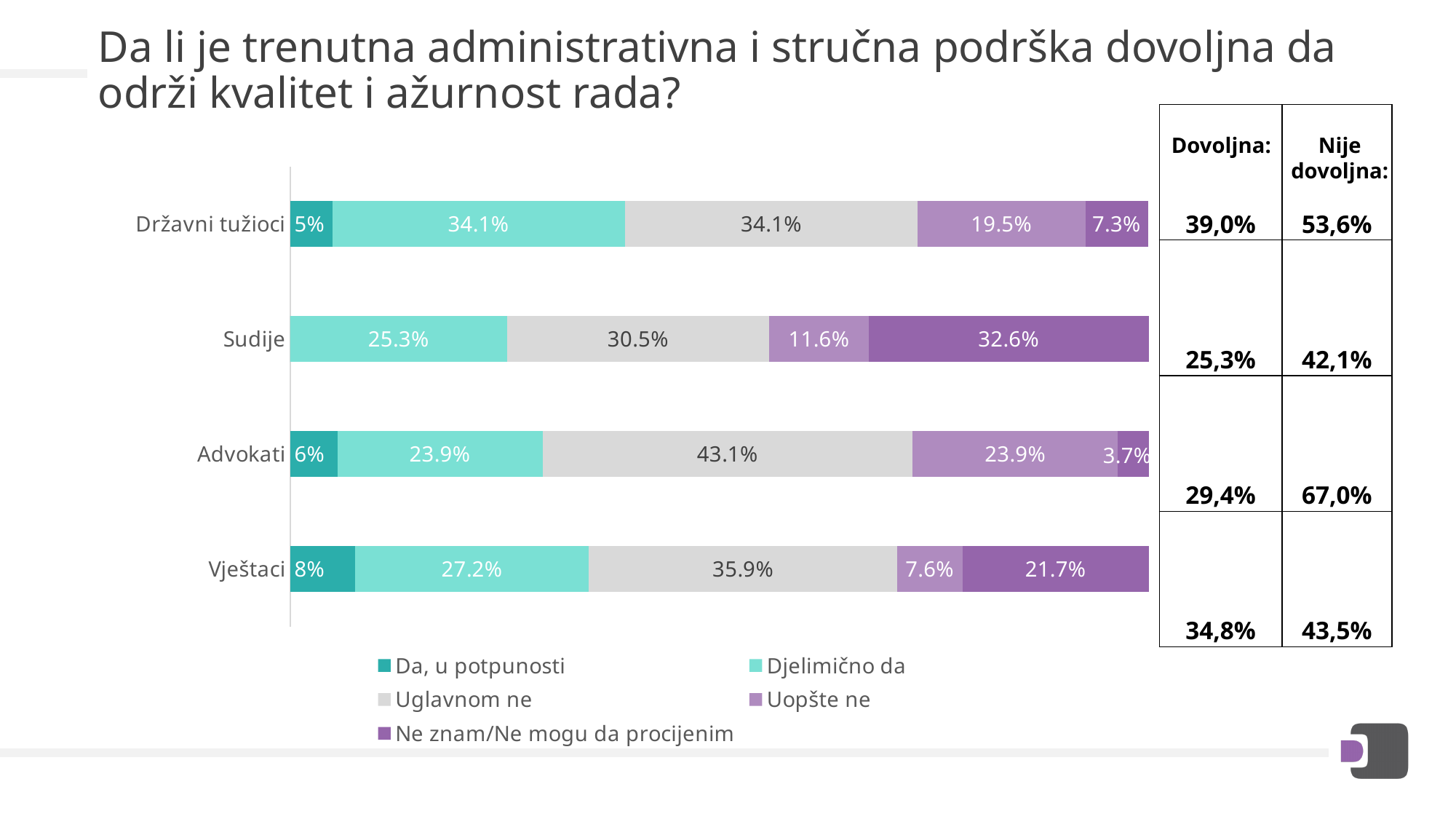
Which category has the highest value for 'Uglavnom ne'? Advokati What type of chart is shown on the slide? stacked bar chart Which category has the lowest value for 'Ne znam/Ne mogu da procijenim'? Advokati Which legend entry is shown in the darkest purple colour? Ne znam/Ne mogu da procijenim Which is larger: 'Uopšte ne' for Advokati or 'Uopšte ne' for Vještaci? Advokati What is the value of 'Uglavnom ne' for Advokati? 43.1% What is the value of 'Uopšte ne' for Državni tužioci? 19.5% What is the value of 'Djelimično da' for Vještaci? 27.2% How many series does the legend list? 5 What is the difference between the 'Djelimično da' values for Državni tužioci and Sudije? 8.8% How many categories (groups) are shown on the chart? 4 What is the value of 'Ne znam/Ne mogu da procijenim' for Sudije? 32.6%